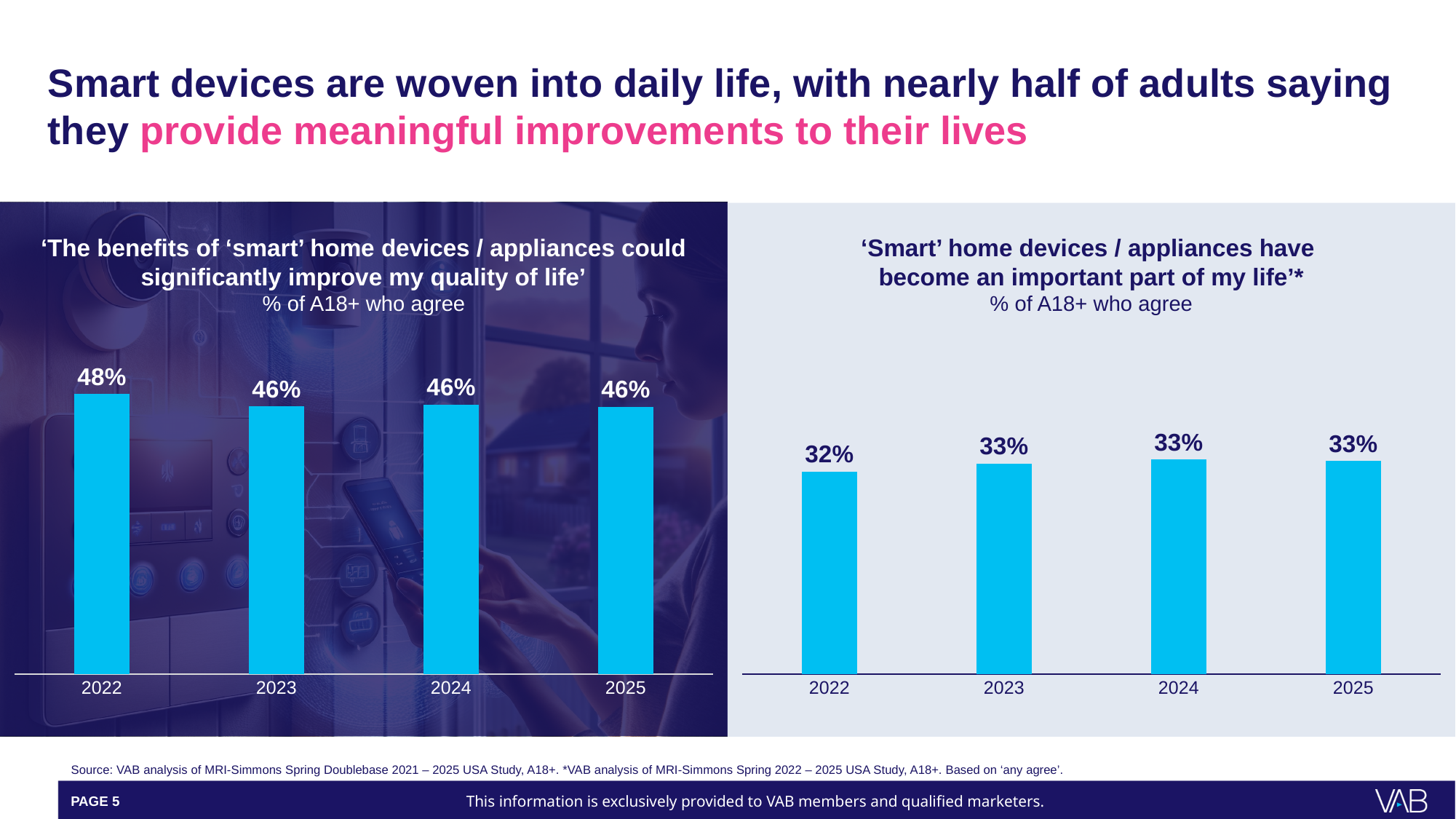
In the right chart ('Smart home devices / appliances have become an important part of my life'), what is the value for 2024? 33% In the right chart ('Smart home devices / appliances have become an important part of my life'), which year has the lowest value? 2022 In the right chart ('Smart home devices / appliances have become an important part of my life'), what is the difference between the 2023 and 2022 values? 1 percentage point In the right chart ('Smart home devices / appliances have become an important part of my life'), what is the value for 2022? 32% In the left chart ('The benefits of smart home devices / appliances could significantly improve my quality of life'), what is the difference between the 2022 and 2023 values? 2 percentage points In the left chart ('The benefits of smart home devices / appliances could significantly improve my quality of life'), what is the value for 2022? 48% Which is larger: the 2022 value in the left chart or the 2022 value in the right chart? The left chart (48%) How many years are shown in the left chart ('The benefits of smart home devices / appliances could significantly improve my quality of life')? 4 In the left chart ('The benefits of smart home devices / appliances could significantly improve my quality of life'), which year has the highest value? 2022 What kind of chart is the right chart ('Smart home devices / appliances have become an important part of my life')? Bar chart In the left chart ('The benefits of smart home devices / appliances could significantly improve my quality of life'), do the values rise or fall from 2022 to 2023? Fall In the left chart ('The benefits of smart home devices / appliances could significantly improve my quality of life'), what is the value for 2025? 46%